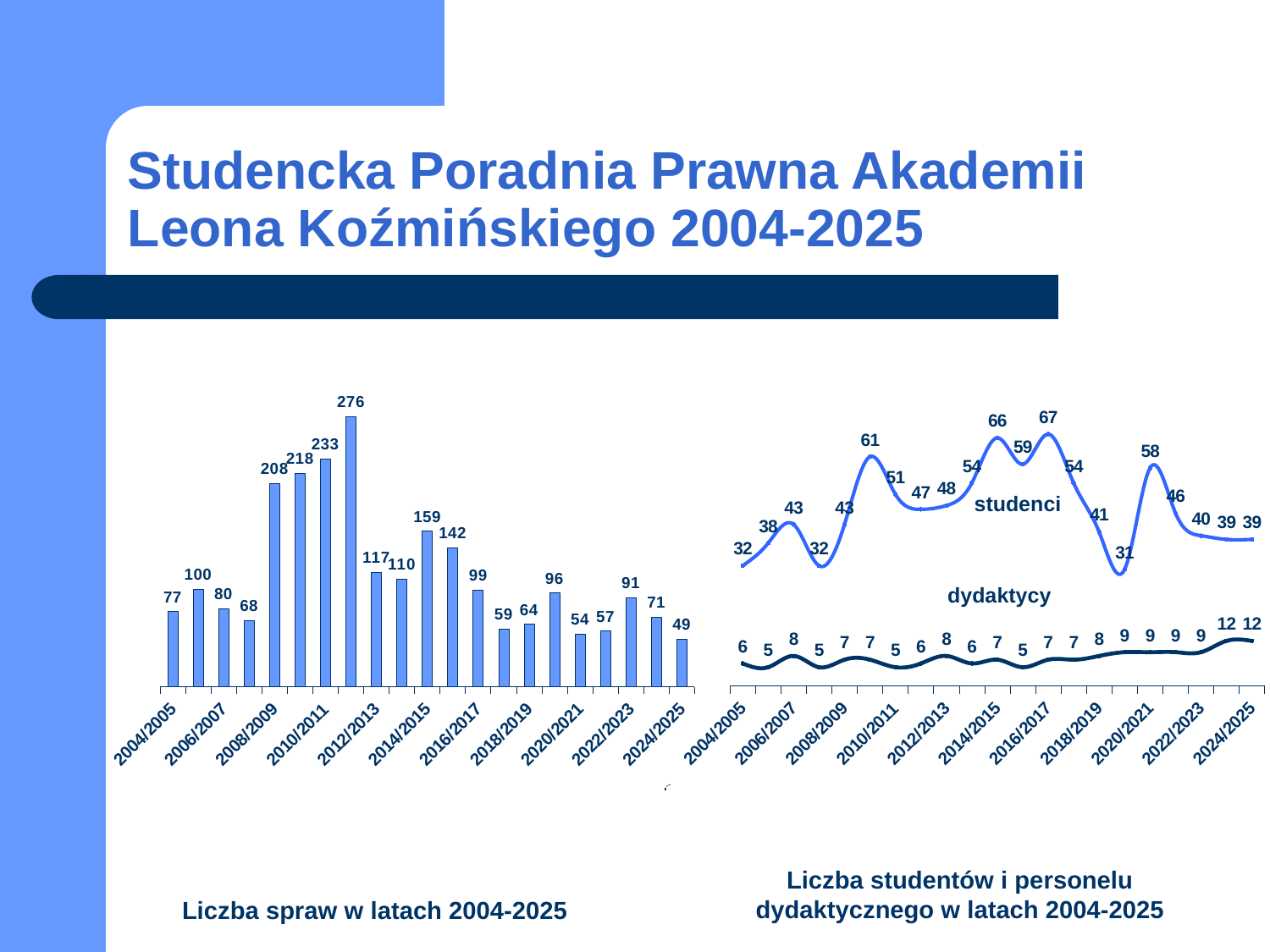
In the chart 'Liczba spraw w latach 2004-2025', how many bars are plotted? 21 How many series are plotted in the chart 'Liczba studentów i personelu dydaktycznego w latach 2004-2025'? 2 In the chart 'Liczba spraw w latach 2004-2025', what is the value for 2010/2011? 233 In the chart 'Liczba spraw w latach 2004-2025', what is the difference between the values for 2008/2009 and 2004/2005? 131 In the chart 'Liczba spraw w latach 2004-2025', which is larger, the value for 2014/2015 or the value for 2016/2017? 2014/2015 In the chart 'Liczba spraw w latach 2004-2025', which year has the highest value? 2011/2012 What are the names of the two series in the chart 'Liczba studentów i personelu dydaktycznego w latach 2004-2025'? studenci and dydaktycy In the chart 'Liczba studentów i personelu dydaktycznego w latach 2004-2025', what is the value of the 'studenci' series for 2016/2017? 67 In the chart 'Liczba studentów i personelu dydaktycznego w latach 2004-2025', what is the value of the 'dydaktycy' series for 2024/2025? 12 In the chart 'Liczba spraw w latach 2004-2025', what is the value for 2024/2025? 49 In the chart 'Liczba studentów i personelu dydaktycznego w latach 2004-2025', what is the difference between the 'studenci' and 'dydaktycy' values for 2020/2021? 49 What kind of chart is 'Liczba spraw w latach 2004-2025'? bar chart